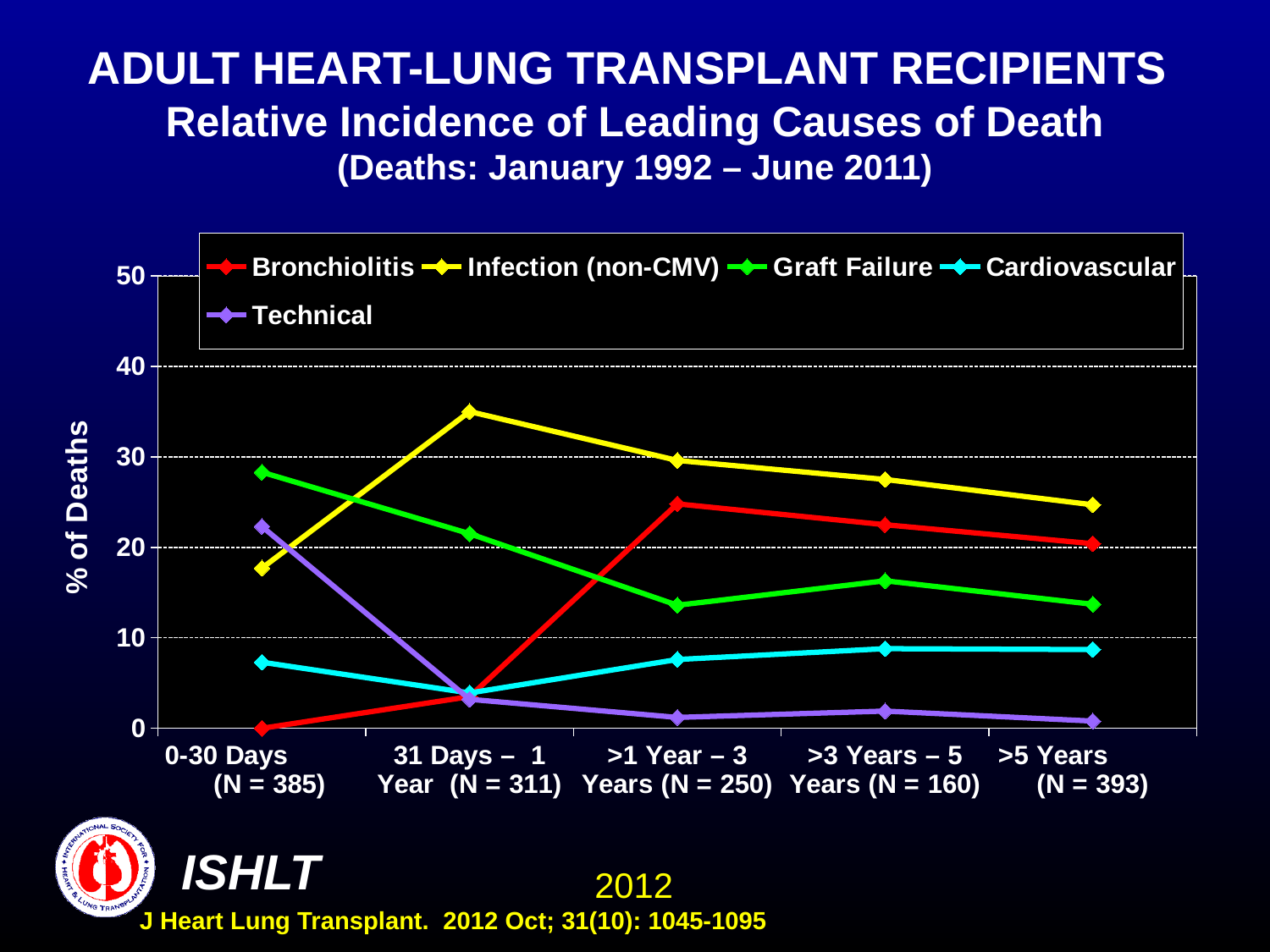
How many time-period categories are shown on the x axis? 5 In the >1 Year – 3 Years period, which is larger: Bronchiolitis or Graft Failure? Bronchiolitis Which cause of death has the highest % of deaths in the 31 Days – 1 Year period? Infection (non-CMV) Is the value for Infection (non-CMV) in the 31 Days – 1 Year period greater or less than 30? greater What is the title of the y axis? % of Deaths What kind of chart is shown on the slide? line chart Is the value for Technical in the 0-30 Days period greater or less than 20? greater Is the value for Cardiovascular in the >3 Years – 5 Years period greater or less than 10? less Which cause of death has the lowest % of deaths in the >5 Years period? Technical How many series does the legend list? 5 Does the Infection (non-CMV) line rise or fall from the 31 Days – 1 Year period to the >5 Years period? fall Which cause of death has the highest % of deaths in the 0-30 Days period? Graft Failure